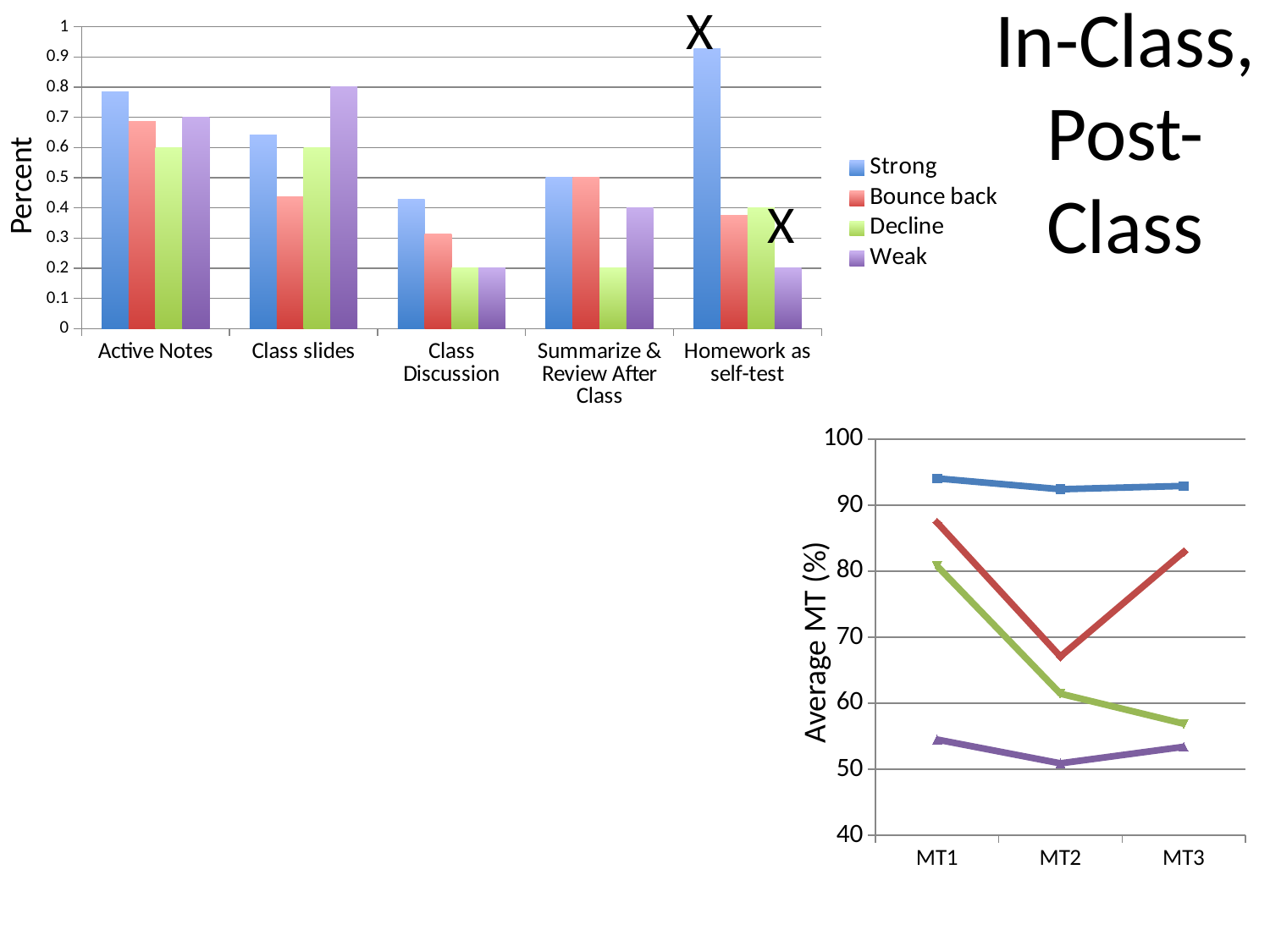
In the top-left bar chart, is the value for Strong in the Homework as self-test category greater or less than 0.9? greater In the top-left bar chart, which is larger for Active Notes: Strong or Bounce back? Strong In the top-left bar chart, how many series does the legend list? 4 In the top-left bar chart, is the value for Bounce back in the Class Discussion category greater or less than 0.4? less In the bottom-right line chart, how many points are shown on the x axis? 3 In the top-left bar chart, how many categories are shown on the x axis? 5 What kind of chart is the top-left chart with the Percent axis? bar chart In the top-left bar chart, what is the value for Weak in the Class slides category? 0.8 In the top-left bar chart, which series has the highest value in the Class slides category? Weak In the top-left bar chart, what is the value for Decline in the Active Notes category? 0.6 What kind of chart is the bottom-right chart with the Average MT (%) axis? line chart In the top-left bar chart, what is the value for Weak in the Summarize & Review After Class category? 0.4